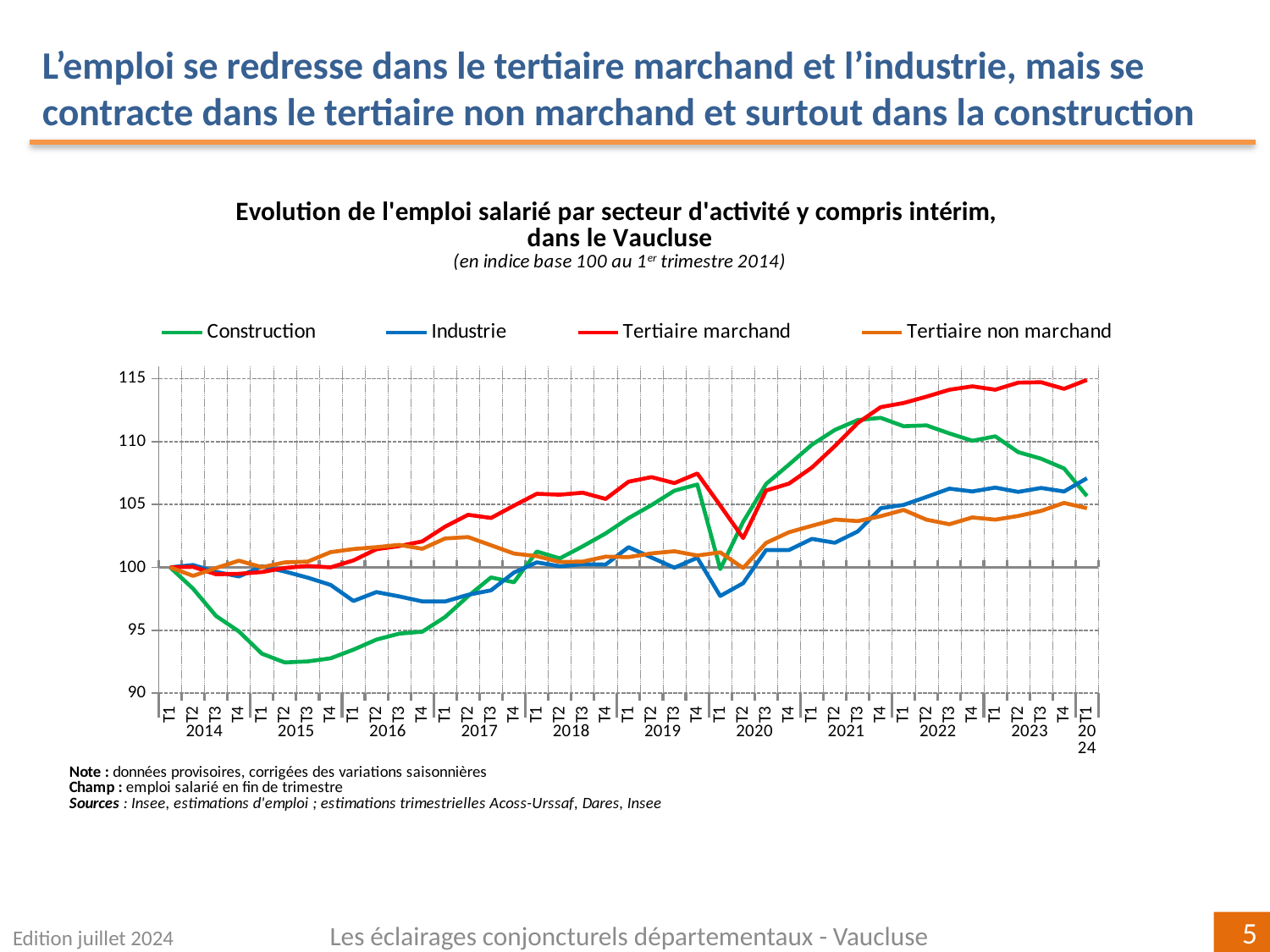
Is the value for Industrie at T1 2020 greater or less than 100? less Which series has the lowest value at T2 2015? Construction Which series are listed in the legend? Construction, Industrie, Tertiaire marchand, Tertiaire non marchand Is the value for Tertiaire marchand at T1 2024 greater or less than 110? greater Which series has the highest value at T1 2024? Tertiaire marchand Does the Construction line rise or fall between T1 2014 and T2 2015? fall How many series does the legend list? 4 Does the Tertiaire marchand line rise or fall between T2 2020 and T1 2024? rise What colour is the Construction line? green At T4 2021, which is larger: Construction or Tertiaire non marchand? Construction What kind of chart is shown on the slide? line chart Is the value for Construction at T2 2015 greater or less than 95? less